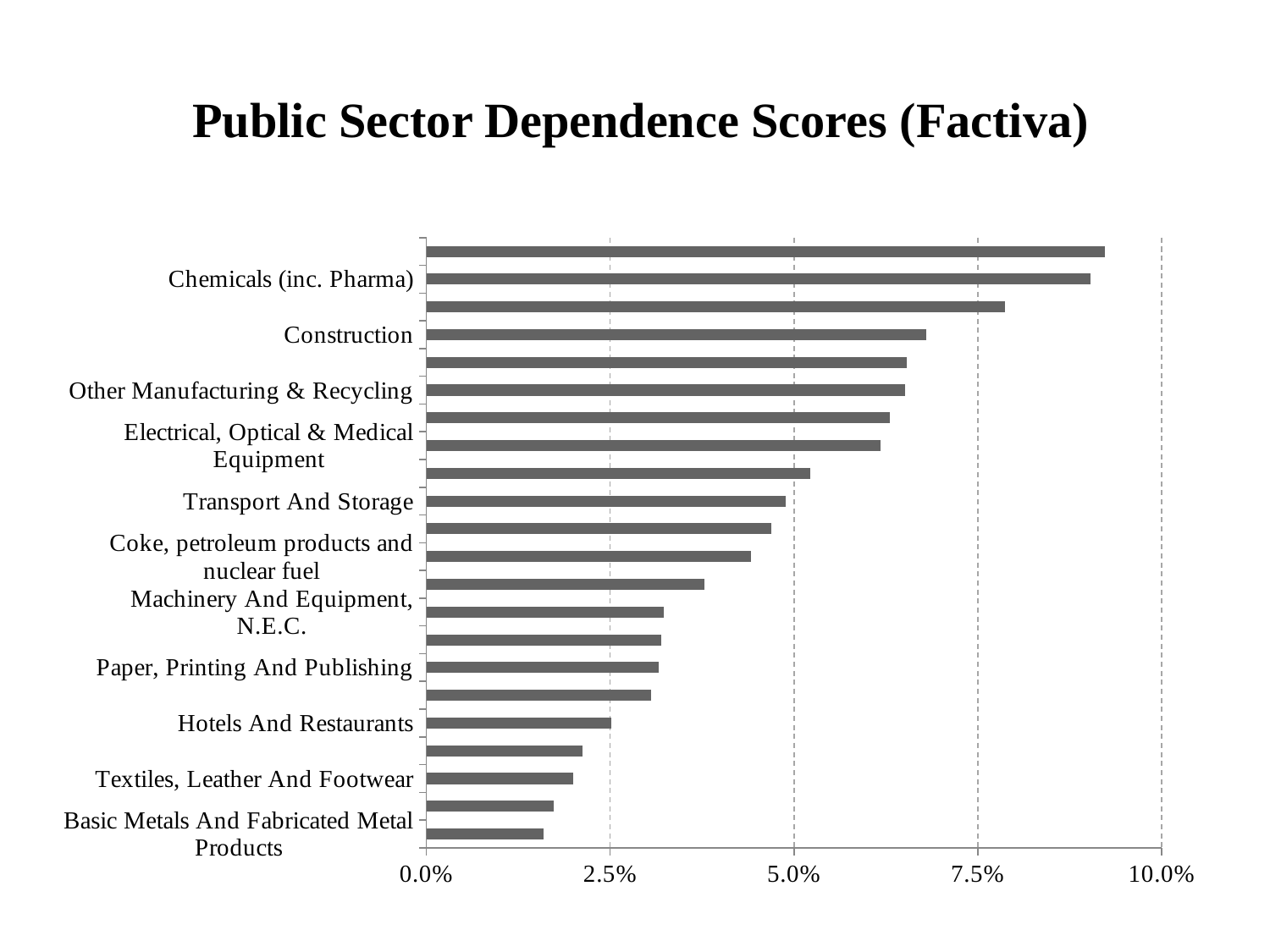
Do the bar values increase or decrease going from the top of the chart to the bottom? decrease What is the title of the chart? Public Sector Dependence Scores (Factiva) Which of the labelled categories has the lowest value? Basic Metals And Fabricated Metal Products Is the value for Paper, Printing And Publishing greater or less than 2.5%? greater What kind of chart is shown on the slide? bar chart Is the value for Chemicals (inc. Pharma) greater or less than 7.5%? greater Is the value for Construction greater or less than 5.0%? greater How many bars are plotted in the chart? 22 Which has the larger value, Construction or Transport And Storage? Construction Which of the labelled categories has the highest value? Chemicals (inc. Pharma)